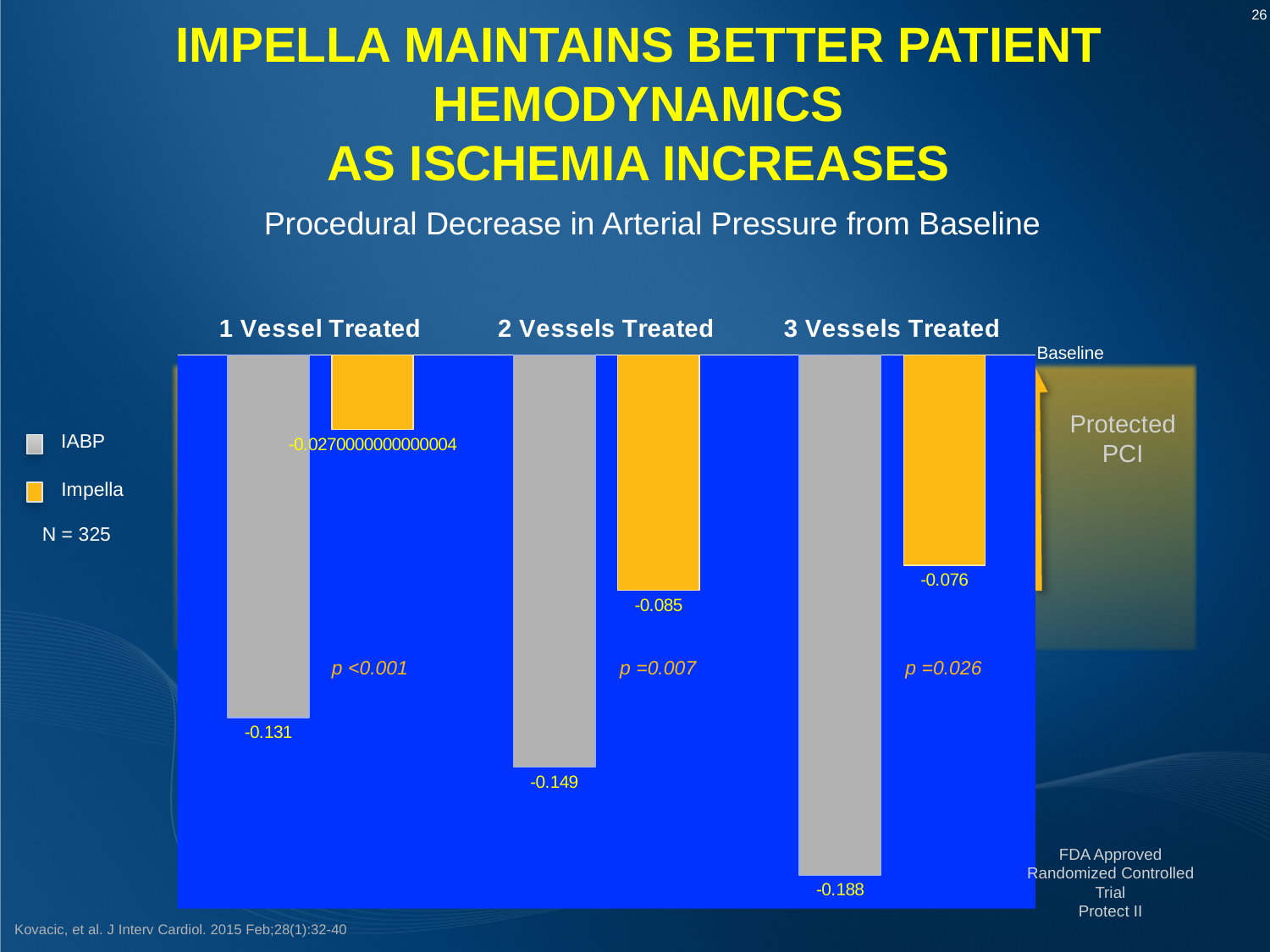
What is the Impella value for 2 Vessels Treated? -0.085 Which category has the lowest IABP value? 3 Vessels Treated How many series does the legend list? 2 Which category has the highest Impella value? 1 Vessel Treated What kind of chart is shown on the slide? bar chart Do the IABP values rise or fall from 1 Vessel Treated to 3 Vessels Treated? fall What is the IABP value for 2 Vessels Treated? -0.149 What p-value is shown for the 1 Vessel Treated comparison? p <0.001 What is the IABP value for 1 Vessel Treated? -0.131 How many vessel-treated categories are plotted on the chart? 3 What is the Impella value for 3 Vessels Treated? -0.076 What is the difference between the IABP and Impella values for 3 Vessels Treated? 0.112